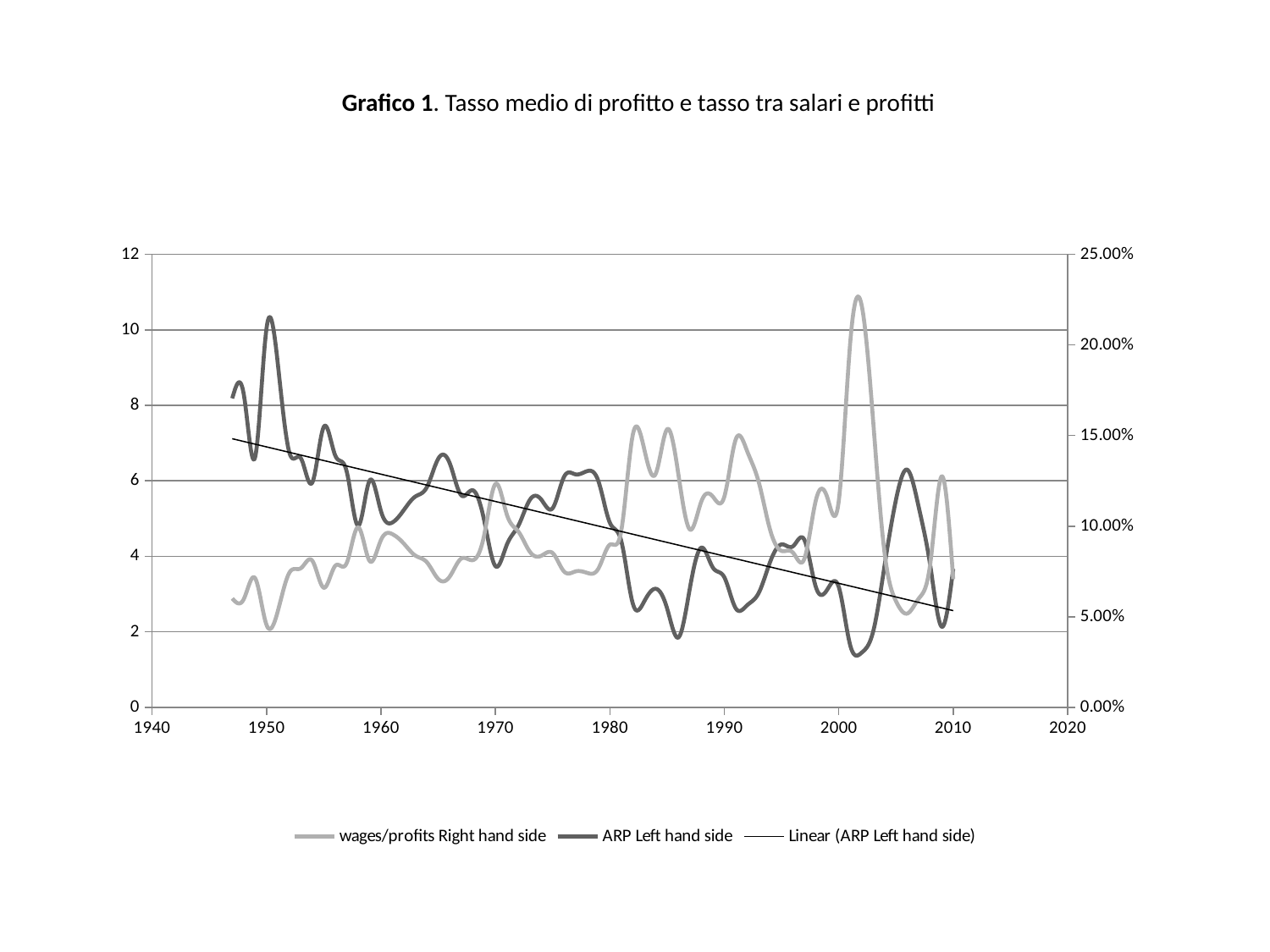
How many entries does the legend list? 3 What is the maximum value shown on the left-hand vertical axis? 12 Does the Linear (ARP Left hand side) trend line slope upward or downward over time? downward What is the title of the chart? Grafico 1. Tasso medio di profitto e tasso tra salari e profitti Does the ARP Left hand side series generally rise or fall from 1947 to 2010? fall What kind of chart is shown on the slide? line chart